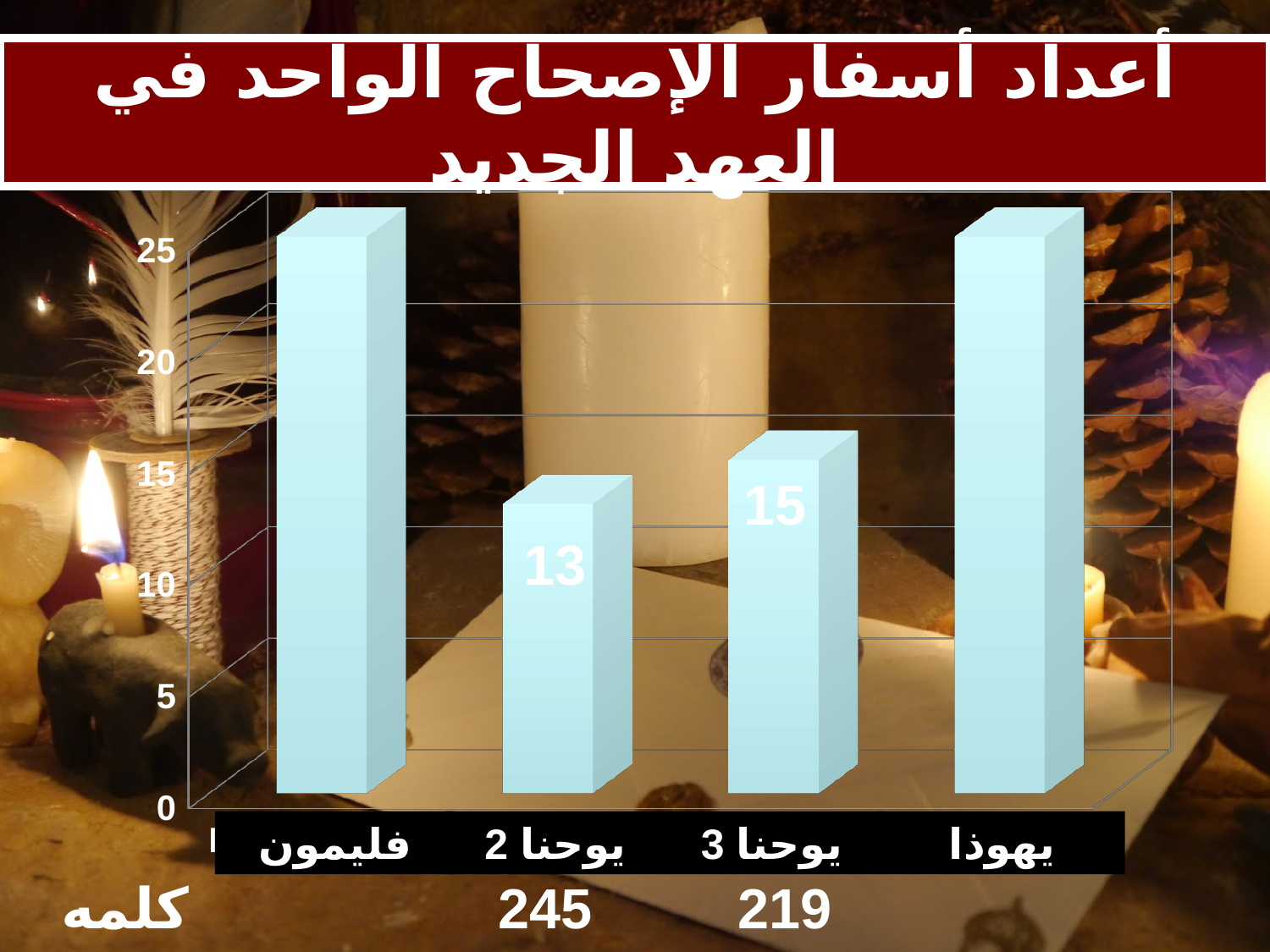
Which has the larger value, يوحنا 2 or يوحنا 3? يوحنا 3 Is the value for فليمون greater or less than 20? greater How many categories are shown on the x axis of the chart? 4 Which category has the lowest value in the chart? يوحنا 2 What is the title of the slide? أعداد أسفار الإصحاح الواحد في العهد الجديد What is the highest value shown on the vertical axis of the chart? 25 What is the difference between the values for يوحنا 3 and يوحنا 2? 2 What is the value for يوحنا 2 in the chart? 13 What is the value for يوحنا 3 in the chart? 15 Is the value for يوحنا 2 greater or less than 15? less What kind of chart is shown on the slide? bar chart Is the value for يهوذا greater or less than 20? greater